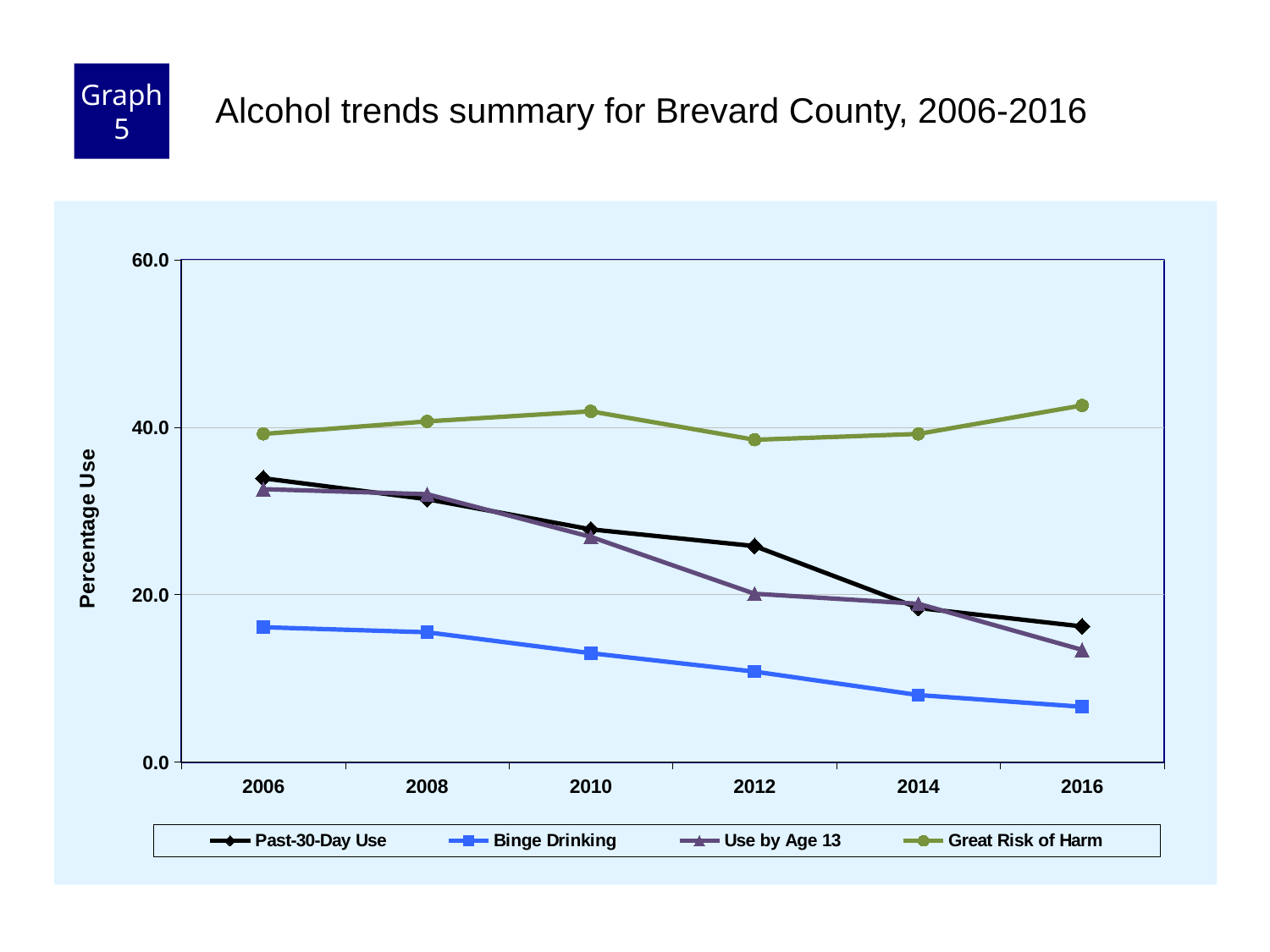
How many years are plotted along the x axis? 6 Is the value for Use by Age 13 in 2006 greater or less than 20? greater Is the value for Great Risk of Harm in 2010 greater or less than 40? greater Which series has the highest values across all years? Great Risk of Harm Is the value for Past-30-Day Use in 2006 greater or less than 40? less What is the label on the y axis? Percentage Use What kind of chart is shown on the slide? line chart How many series does the legend list? 4 Which series has the lowest values across all years? Binge Drinking Does Binge Drinking rise or fall from 2006 to 2016? fall In 2012, which is larger: Past-30-Day Use or Use by Age 13? Past-30-Day Use